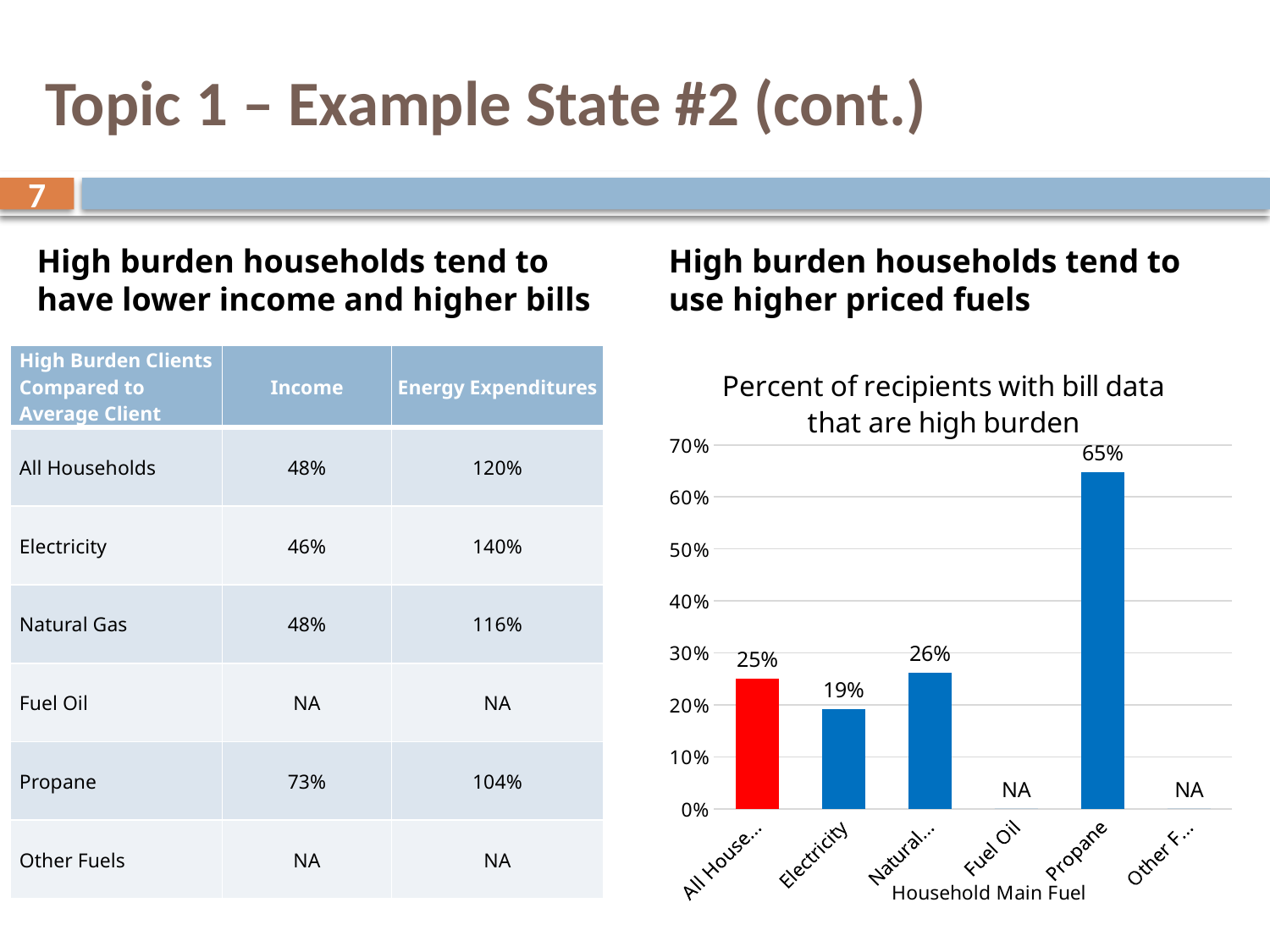
Among the categories with a plotted bar, which has the lowest value? Electricity Which category has the highest value in the chart? Propane What is the x-axis title of the chart? Household Main Fuel What is shown for Fuel Oil in the chart? NA What is the difference between the values for Propane and Electricity? 46 percentage points Which is larger, the value for Propane or the value for Electricity? Propane What type of chart is shown on the slide? bar chart What is the title of the chart? Percent of recipients with bill data that are high burden What is the value for Propane in the chart? 65% Is the value for Propane greater or less than 60%? greater What is the value for Electricity in the chart? 19% How many categories are shown on the x axis of the chart? 6